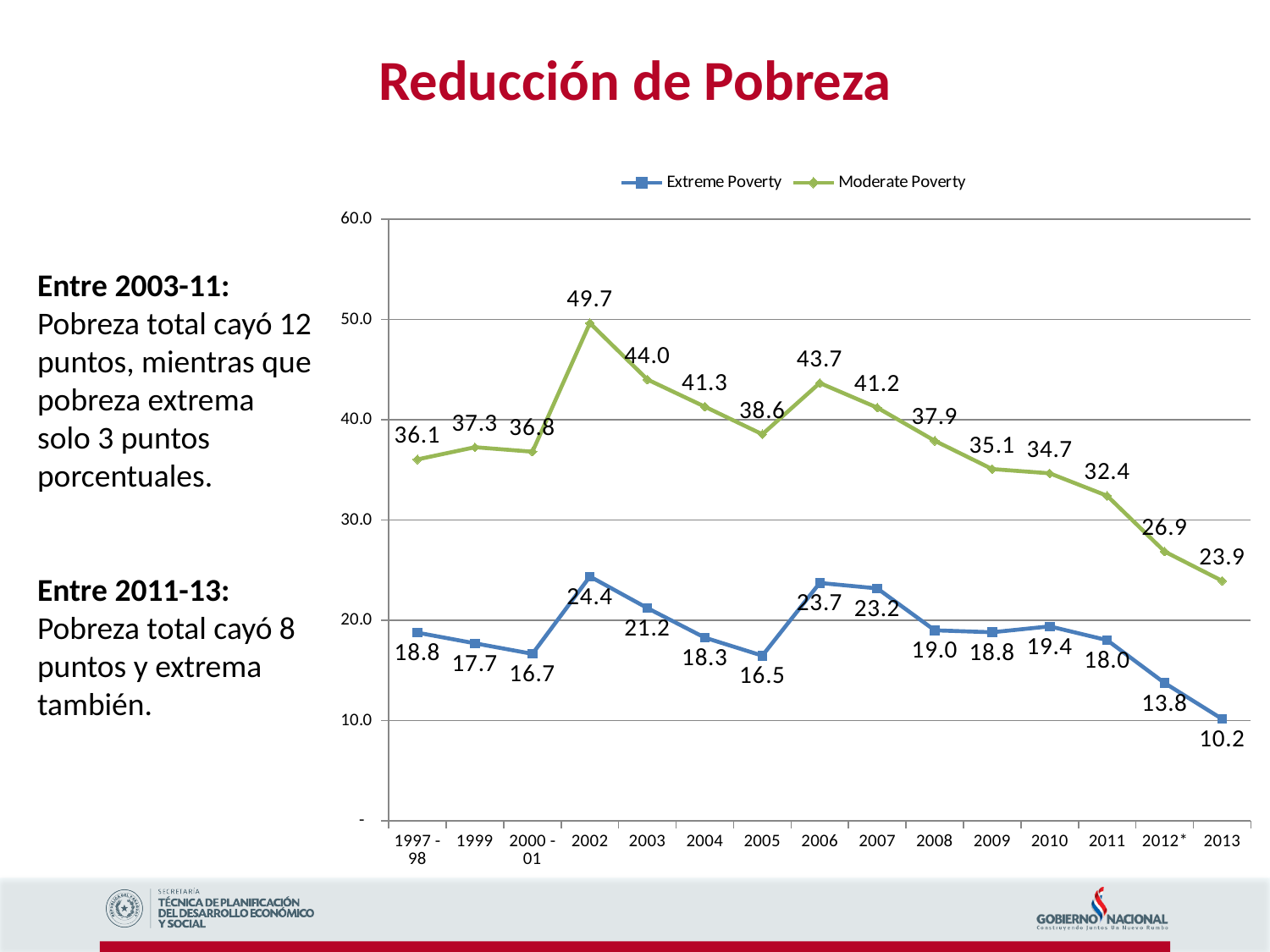
What type of chart is shown on the slide? line chart In which year is Extreme Poverty at its lowest value? 2013 What is the Extreme Poverty value for 2013? 10.2 How many time periods are shown on the x axis? 15 What is the difference between Moderate Poverty and Extreme Poverty in 2013? 13.7 What colour is the Moderate Poverty line? green In which year does Moderate Poverty reach its highest value? 2002 Does Moderate Poverty rise or fall from 2006 to 2013? fall What is the Extreme Poverty value for 2006? 23.7 Which is larger: the Extreme Poverty value for 2002 or for 2005? 2002 How many series does the legend list? 2 What is the Moderate Poverty value for 2002? 49.7